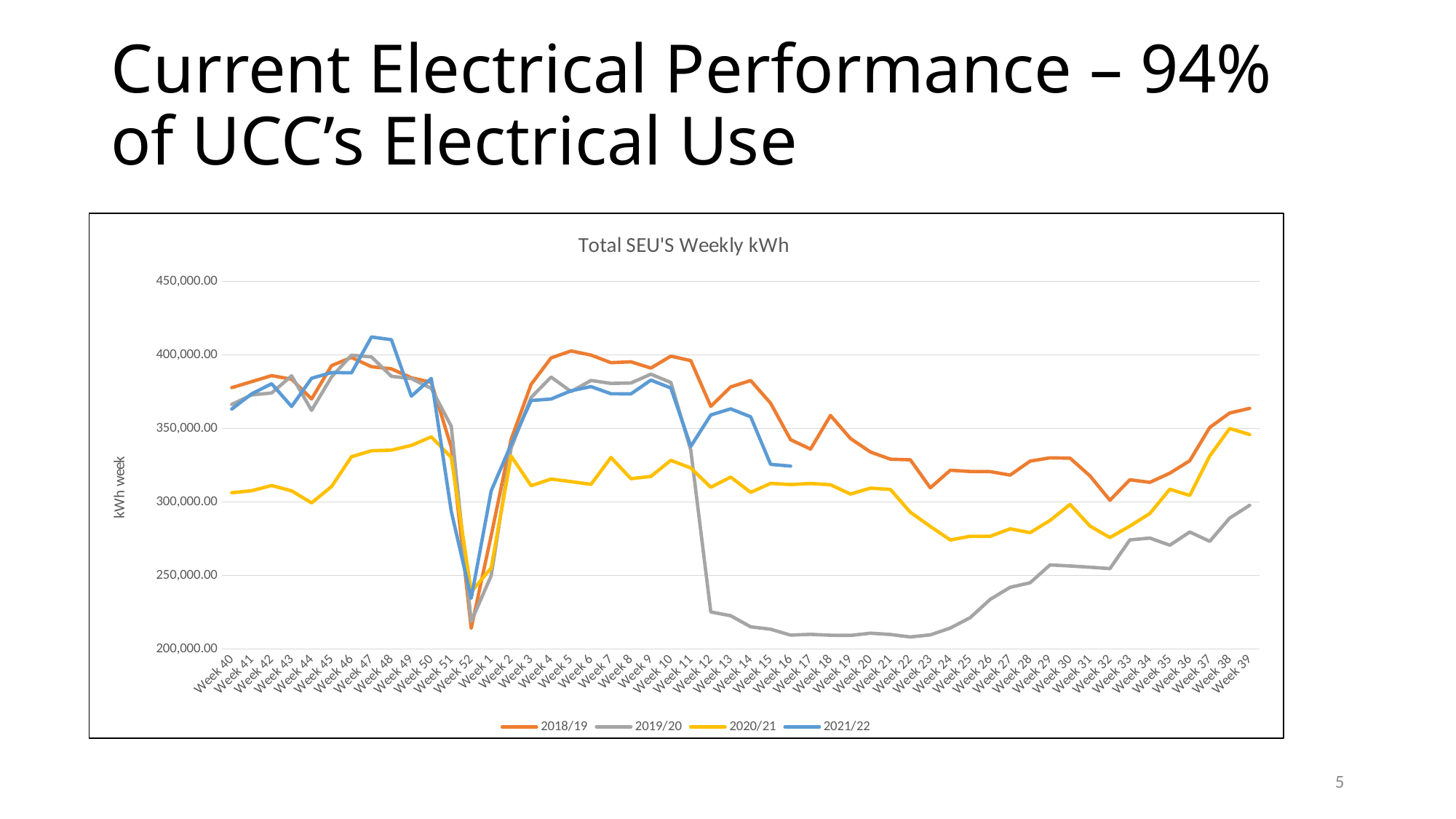
What kind of chart is shown on the slide? line chart Which series stops at Week 16 rather than continuing to Week 39? 2021/22 How many weeks are shown along the x axis? 52 At Week 20, which series has the higher value, 2018/19 or 2019/20? 2018/19 Is the value for 2018/19 at Week 52 greater or less than 250,000.00? less Is the value for 2020/21 at Week 40 greater or less than 350,000.00? less What is the title of the chart? Total SEU'S Weekly kWh Is the value for 2019/20 at Week 20 greater or less than 250,000.00? less How many series does the legend list? 4 Does the 2019/20 series rise or fall from Week 25 to Week 39? rise Which series has the lowest value at Week 25? 2019/20